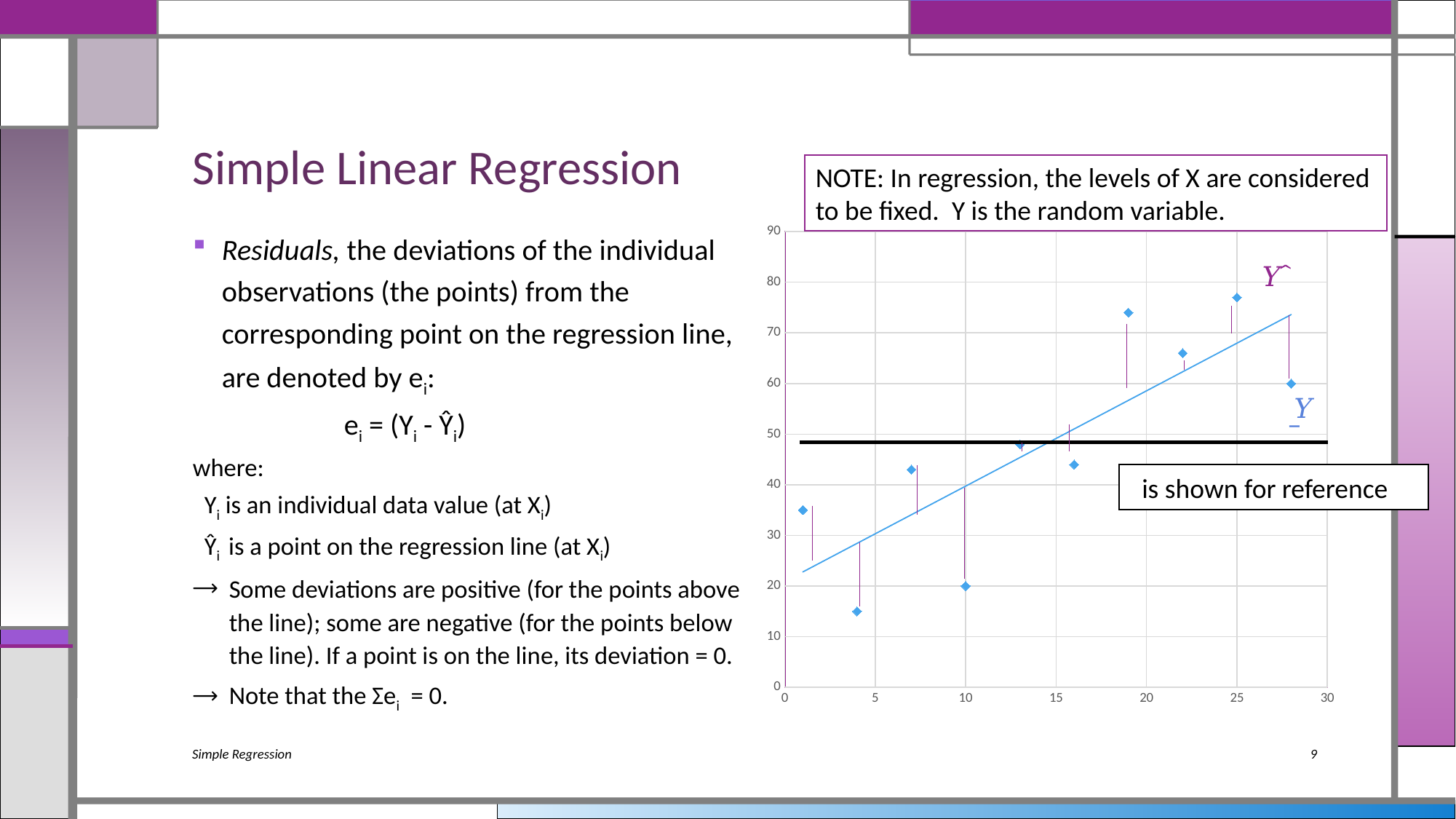
What does the horizontal black line on the chart represent? Ȳ (the mean of Y), shown for reference What is the highest value shown on the vertical axis of the chart? 90 Which point has the lowest Y value, the one at X = 4 or the one at X = 10? X = 4 Do the plotted points generally rise or fall as X increases? rise Which point has the larger Y value, the one at X = 7 or the one at X = 10? X = 7 Is the value of the point at X = 16 greater or less than 50? less Is the value of the point at X = 19 greater or less than 70? greater Is the value of the point at X = 4 greater or less than 20? less What kind of chart is shown on the slide? scatter chart How many data points are plotted in the chart? 10